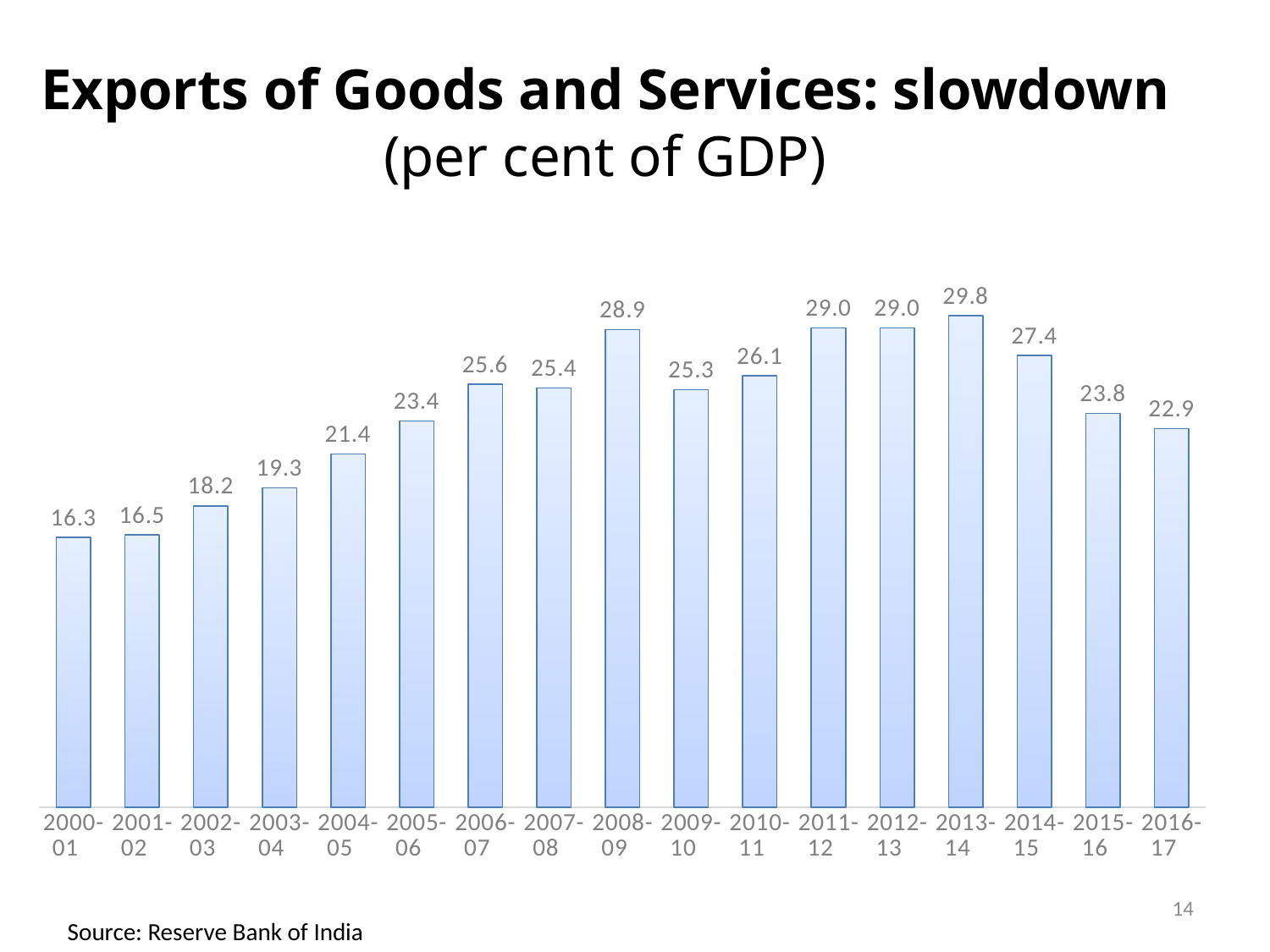
What is the value for 2016-17? 22.9 Which year has the highest value? 2013-14 What is the value for 2008-09? 28.9 What is the difference between the values for 2008-09 and 2009-10? 3.6 How many years are shown on the x axis? 17 Do the values rise or fall from 2013-14 to 2016-17? Fall What kind of chart is shown on the slide? Bar chart Which is larger, the value for 2006-07 or the value for 2007-08? 2006-07 What is the difference between the values for 2013-14 and 2016-17? 6.9 What is the source cited for the chart? Reserve Bank of India Which year has the lowest value? 2000-01 What is the value for 2000-01? 16.3